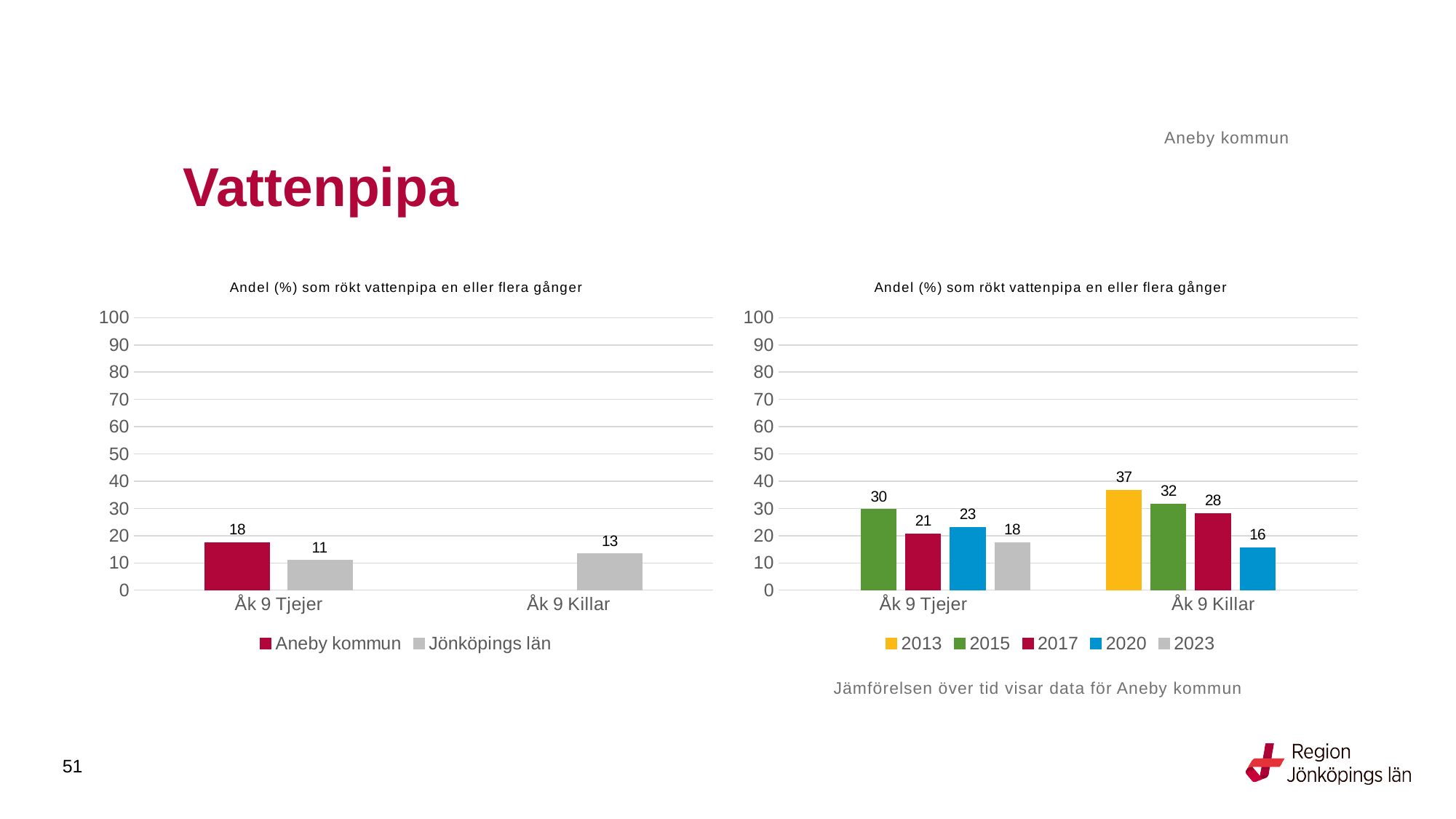
In the left chart, what is the value for Aneby kommun for Åk 9 Tjejer? 18 In the right chart, which year has the lowest value for Åk 9 Tjejer? 2023 In the left chart, how many series does the legend list? 2 In the right chart, what is the value for 2013 for Åk 9 Killar? 37 In the left chart, what is the difference between Aneby kommun and Jönköpings län for Åk 9 Tjejer? 7 What kind of chart is the left chart? Bar chart In the right chart, what is the value for 2020 for Åk 9 Tjejer? 23 In the right chart, how many series does the legend list? 5 In the right chart, which is larger for Åk 9 Tjejer: 2015 or 2017? 2015 In the right chart, what is the difference between 2015 and 2020 for Åk 9 Killar? 16 In the left chart, what is the value for Jönköpings län for Åk 9 Killar? 13 In the right chart, which year has the highest value for Åk 9 Killar? 2013